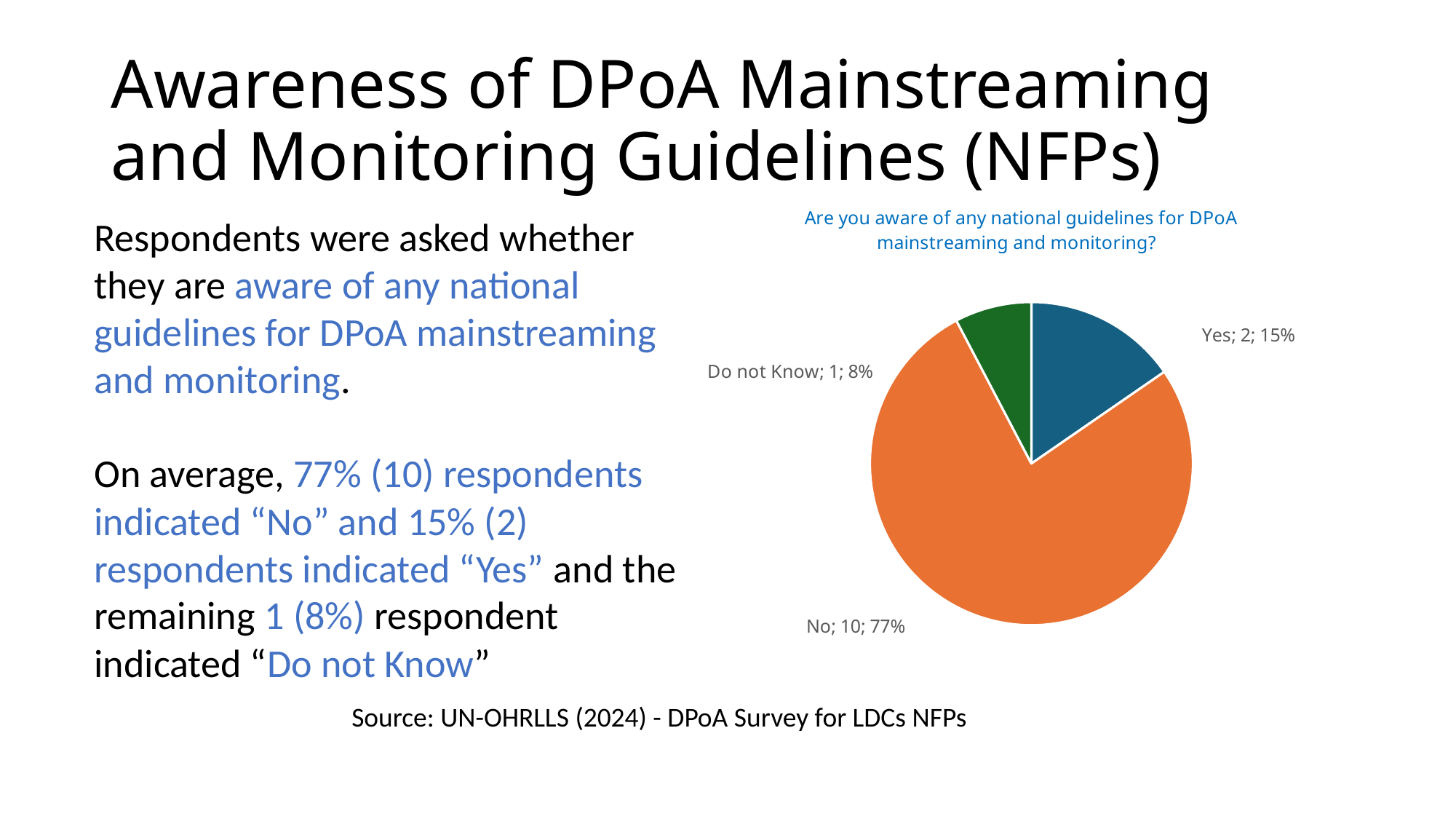
What share of the pie does the "No" slice represent? 77% What percentage of respondents answered "Yes"? 15% How many respondents answered "No"? 10 Which has more respondents, "Yes" or "Do not Know"? Yes How many categories are shown in the pie chart? 3 What share of the pie does the "Do not Know" slice represent? 8% How many respondents answered "Do not Know"? 1 Which response category has the smallest slice? Do not Know What kind of chart is shown on the slide? pie chart Which response category has the largest slice? No What is the title of the pie chart? Are you aware of any national guidelines for DPoA mainstreaming and monitoring? How many more respondents answered "No" than "Yes"? 8